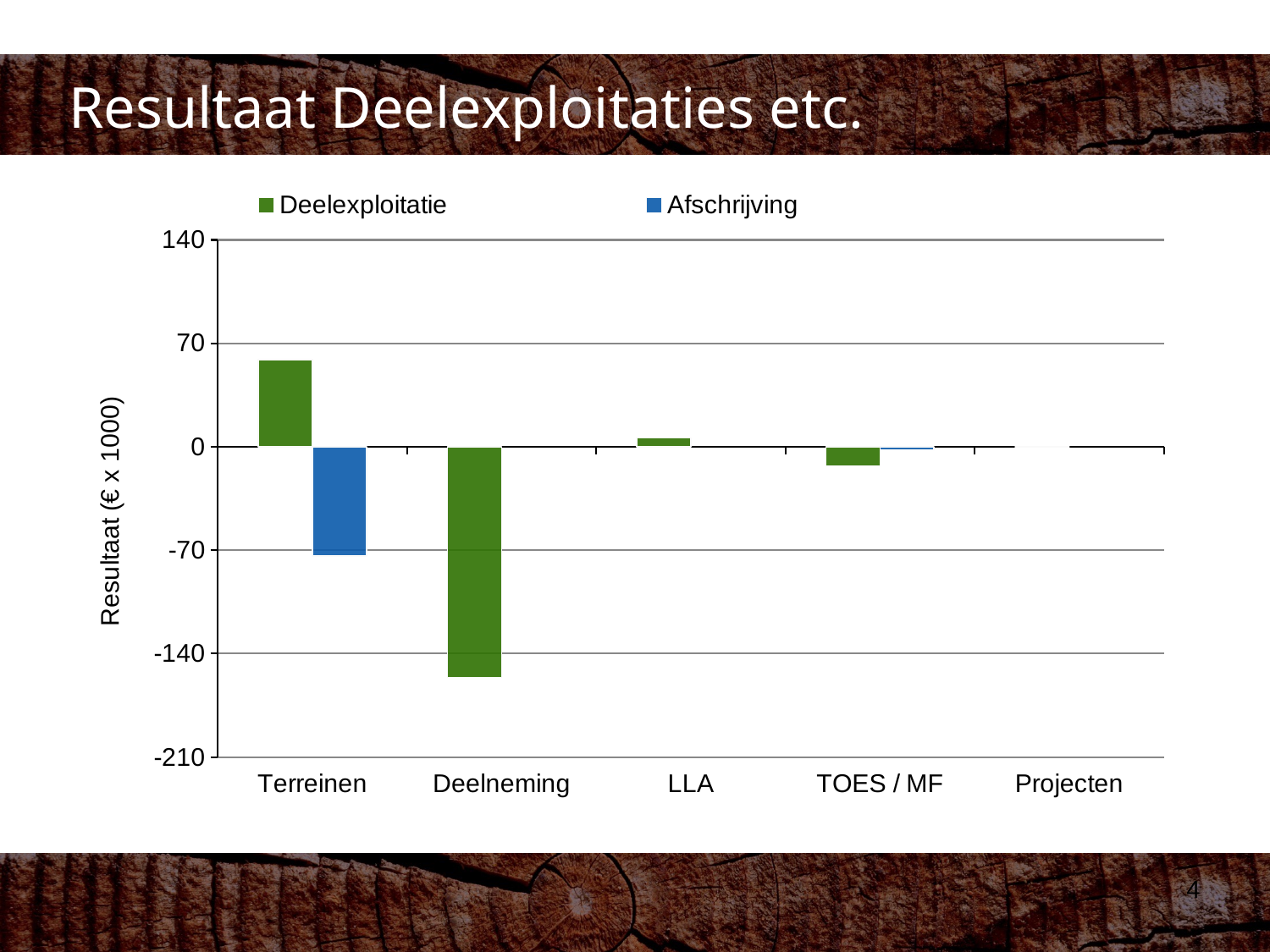
Is the Afschrijving value for Terreinen greater or less than 0? less Is the Deelexploitatie value for Deelneming greater or less than -140? less How many series does the legend list? 2 What is the label on the y axis? Resultaat (€ x 1000) Which category has the lowest Deelexploitatie value? Deelneming What is the title of the slide? Resultaat Deelexploitaties etc. Which category has the highest Deelexploitatie value? Terreinen What kind of chart is shown on the slide? bar chart How many categories are shown on the x axis? 5 Is the Deelexploitatie value for TOES / MF greater or less than 0? less Which is larger, the Deelexploitatie value for Terreinen or for Deelneming? Terreinen